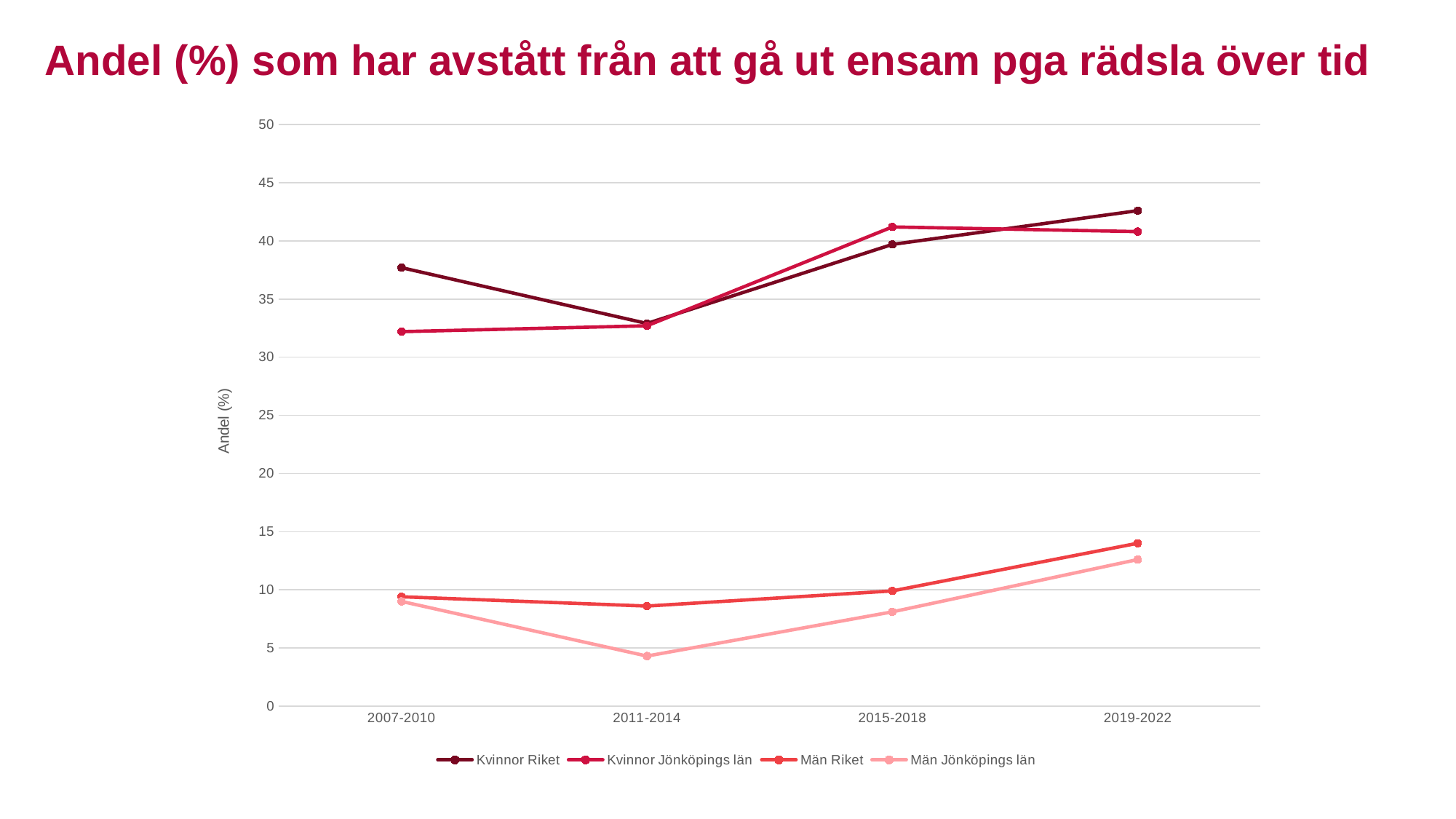
Is the value for Kvinnor Riket in 2007-2010 greater or less than 35? greater What is the label on the y axis? Andel (%) In 2019-2022, which is higher: Kvinnor Riket or Kvinnor Jönköpings län? Kvinnor Riket In 2015-2018, which is higher: Kvinnor Jönköpings län or Kvinnor Riket? Kvinnor Jönköpings län How many time periods are shown on the x axis? 4 Is the value for Män Riket in 2019-2022 greater or less than 10? greater Is the value for Män Jönköpings län in 2011-2014 greater or less than 5? less What kind of chart is shown on the slide? line chart In which period is the value for Män Jönköpings län lowest? 2011-2014 In which period is the value for Kvinnor Riket highest? 2019-2022 Does the Män Riket line rise or fall from 2011-2014 to 2019-2022? rise How many series does the legend list? 4